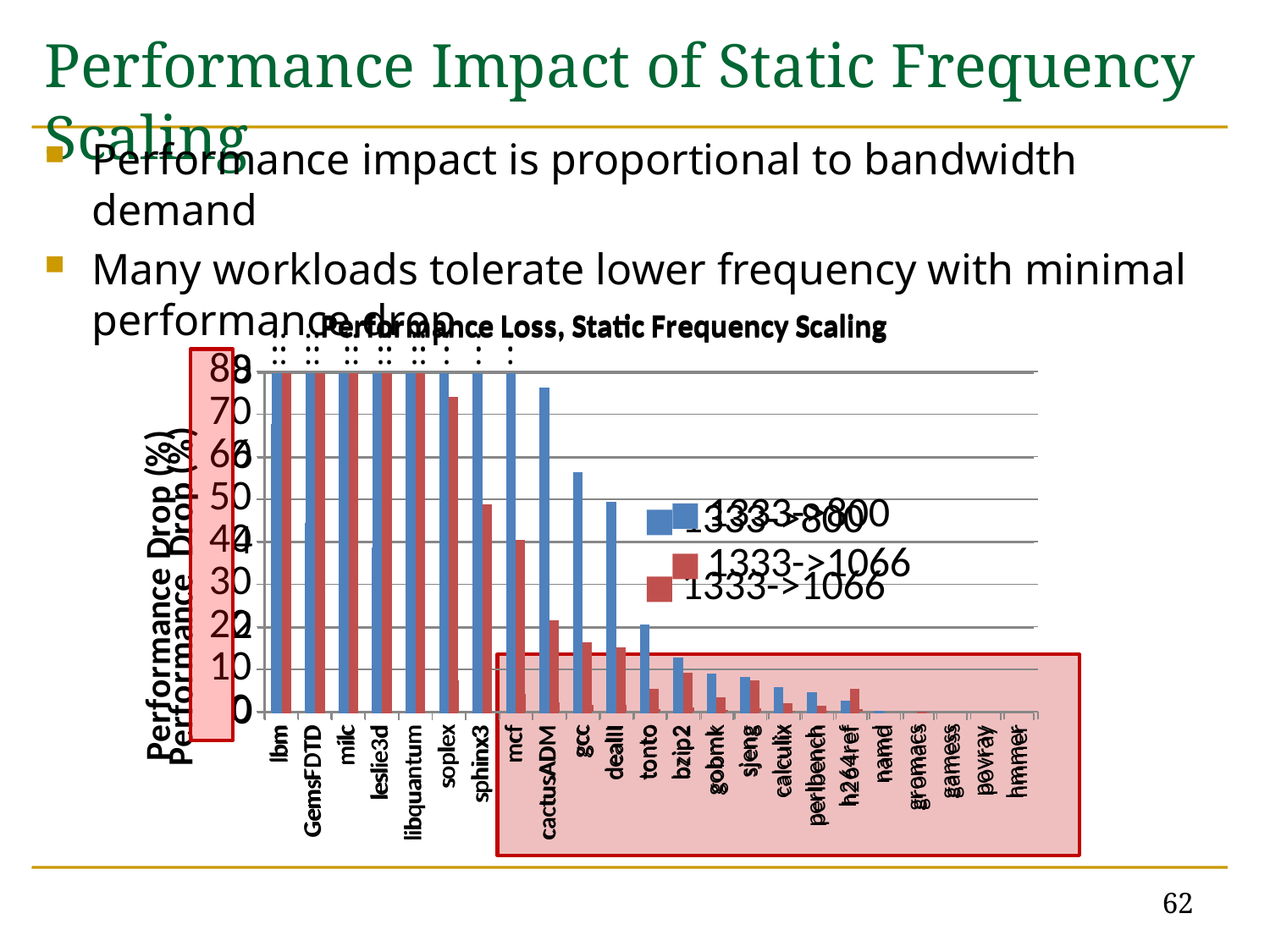
How many workload categories are plotted along the x axis? 23 What is the title of the chart? Performance Loss, Static Frequency Scaling How many series does the chart legend list? 2 For gcc, which series has the larger value, 1333->800 or 1333->1066? 1333->800 Is the 1333->1066 value for tonto greater or less than 10? less What are the two series named in the chart legend? 1333->800 and 1333->1066 What kind of chart is shown on the slide? bar chart Do the 1333->800 values generally rise or fall moving from left to right along the x axis? fall